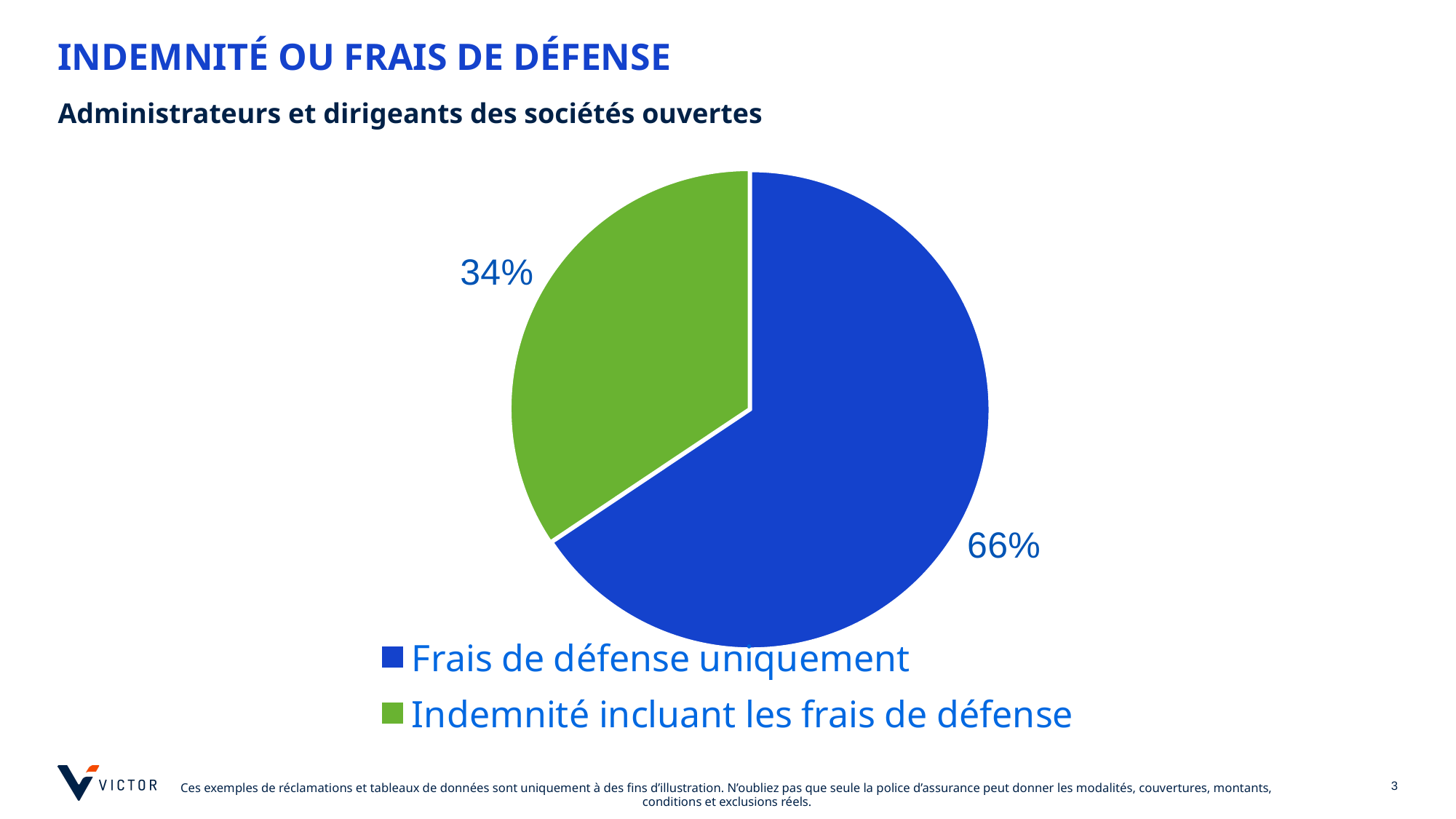
Which slice is the largest? Frais de défense uniquement What is the difference in percentage points between 'Frais de défense uniquement' and 'Indemnité incluant les frais de défense'? 32 How many entries does the legend list? 2 Which slice is the smallest? Indemnité incluant les frais de défense What colour is the 'Indemnité incluant les frais de défense' slice? green What share of the pie is 'Frais de défense uniquement'? 66% How many slices does the pie chart have? 2 What share of the pie is 'Indemnité incluant les frais de défense'? 34% What is the subtitle shown above the chart? Administrateurs et dirigeants des sociétés ouvertes Which is larger: 'Frais de défense uniquement' or 'Indemnité incluant les frais de défense'? Frais de défense uniquement What kind of chart is shown on the slide? pie chart